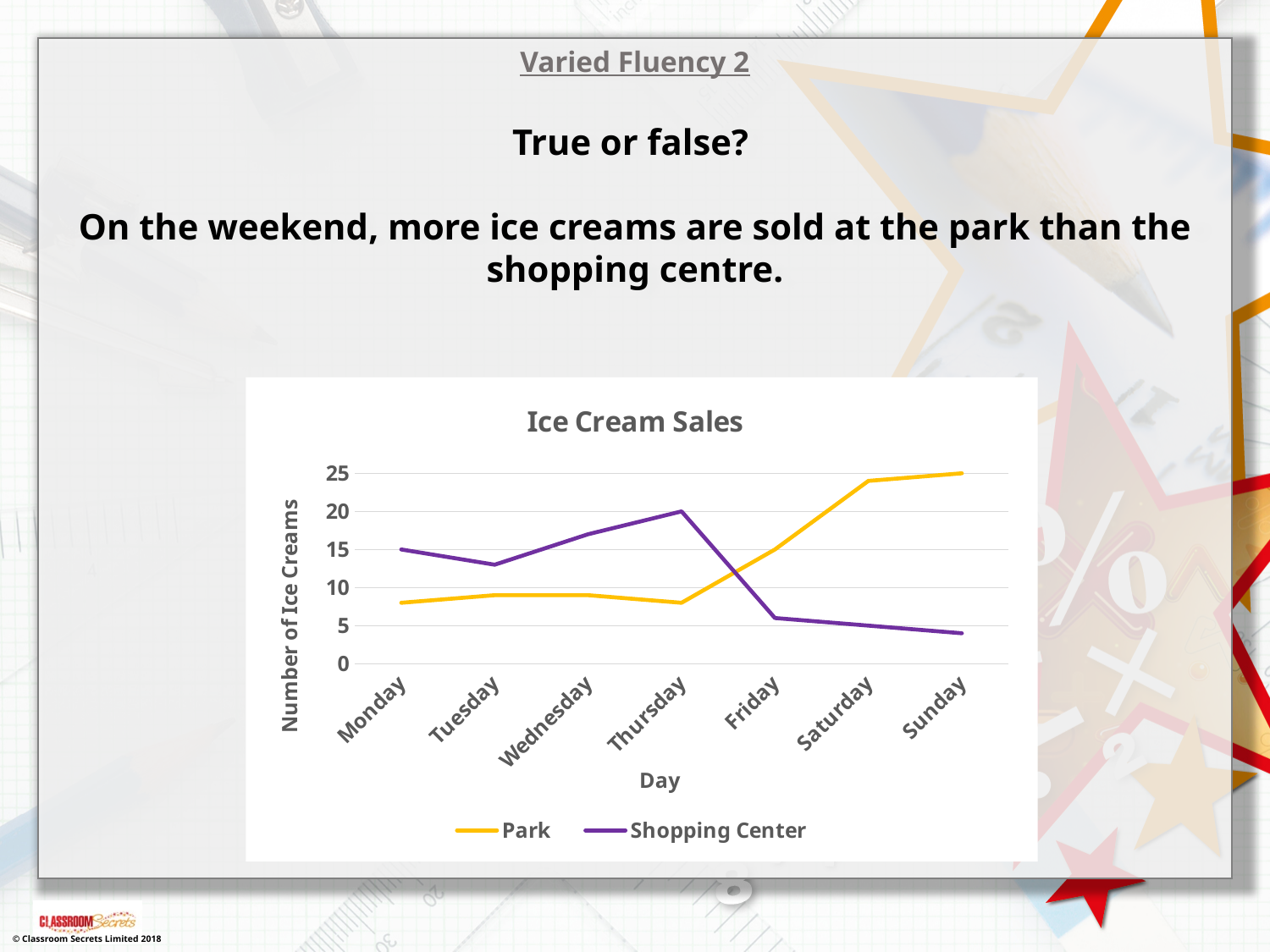
How many ice creams were sold at the Shopping Center on Thursday? 20 What kind of chart is shown on the slide? Line chart Is the value for the Park on Monday greater or less than 10? less Is the value for the Shopping Center on Sunday greater or less than 5? less Do Shopping Center sales rise or fall from Thursday to Sunday? Fall On Saturday, which series has the higher value, Park or Shopping Center? Park What is the title of the chart? Ice Cream Sales How many days are shown on the x axis? 7 How many ice creams were sold at the Park on Sunday? 25 How many series does the legend list? 2 On which day were Shopping Center sales highest? Thursday How many ice creams were sold at the Shopping Center on Monday? 15